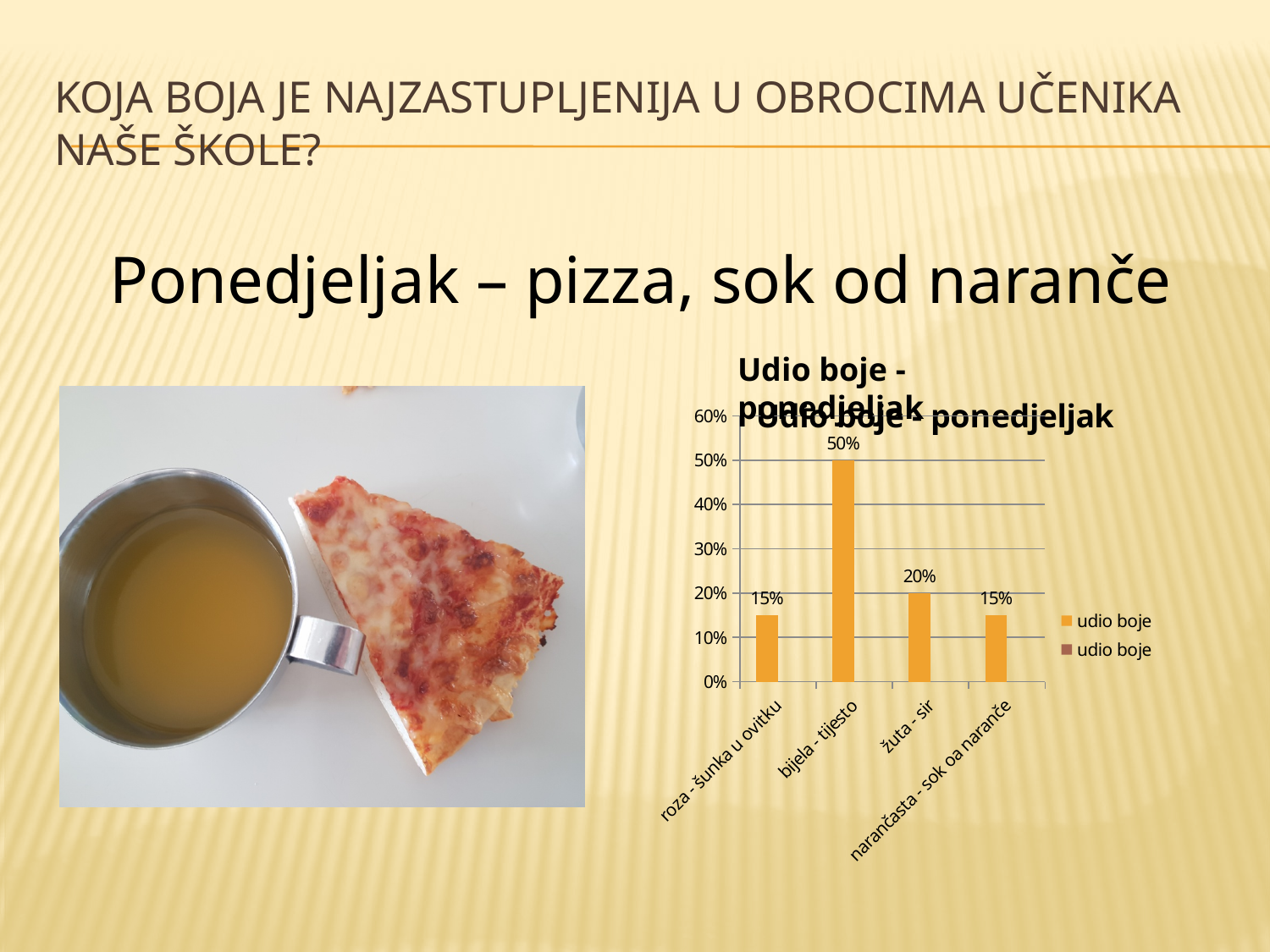
What is the difference between the values for bijela - tijesto and žuta - sir? 30% What is the value for roza - šunka u ovitku? 15% What is the highest value shown on the y axis? 60% What is the value for bijela - tijesto? 50% Which category has the highest value? bijela - tijesto How many entries does the legend list? 2 What kind of chart is shown on the slide? bar chart What is the title of the chart? Udio boje - ponedjeljak How many categories are shown on the x axis? 4 Which is larger, the value for žuta - sir or the value for roza - šunka u ovitku? žuta - sir What is the value for žuta - sir? 20% Is the value for bijela - tijesto greater or less than 40%? greater